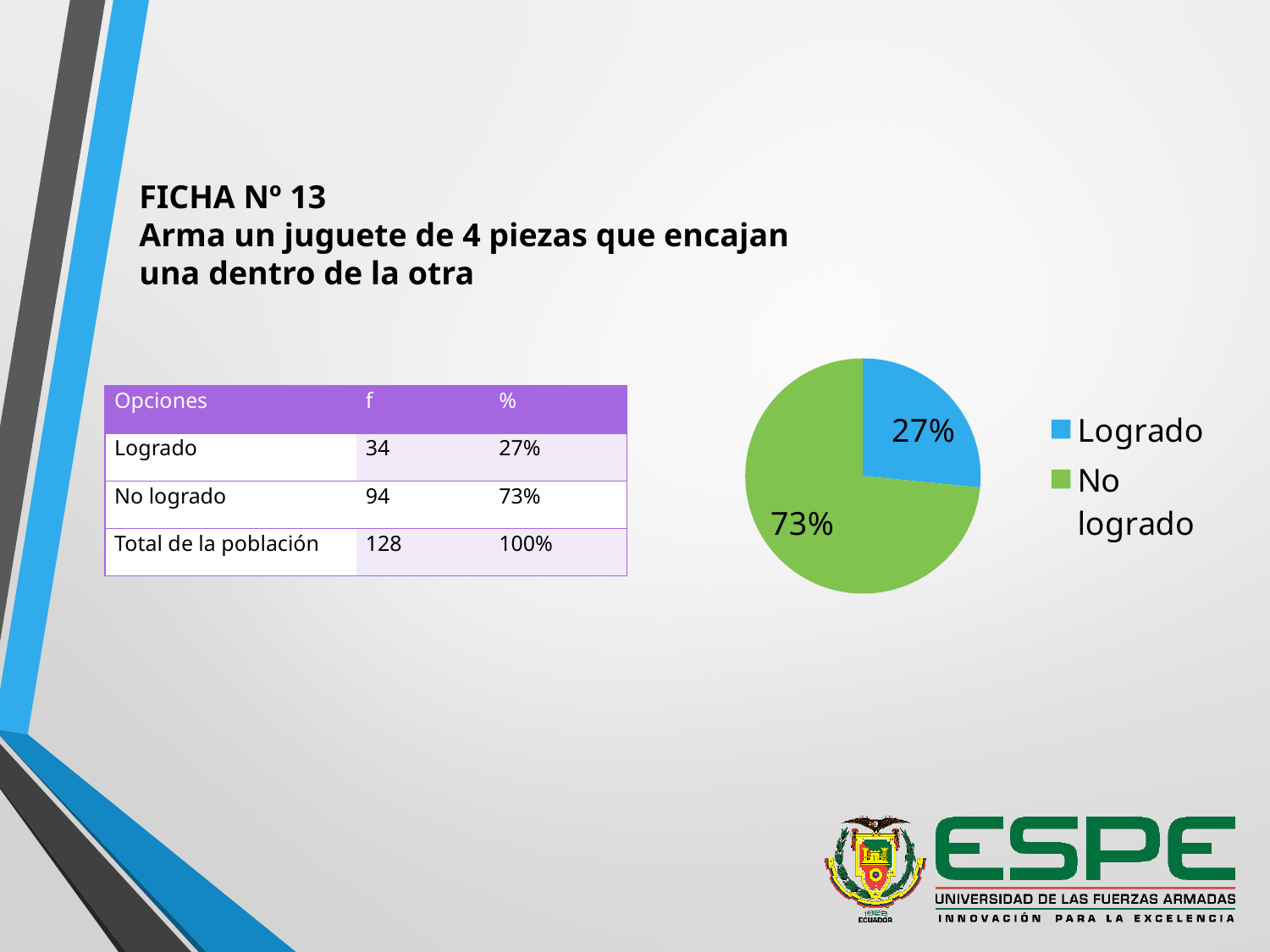
How many slices does the pie chart have? 2 Which category has the largest slice in the pie chart? No logrado What percentage does the Logrado slice show in the pie chart? 27% Which slice is larger in the pie chart, Logrado or No logrado? No logrado What percentage does the No logrado slice show in the pie chart? 73% What is the difference in percentage points between the No logrado and Logrado slices? 46 What colour is the No logrado slice in the pie chart? green What colour is the Logrado slice in the pie chart? blue Which category has the smallest slice in the pie chart? Logrado What kind of chart is shown on the slide? pie chart What share of the pie does the Logrado slice represent? 27% How many entries does the legend of the pie chart list? 2